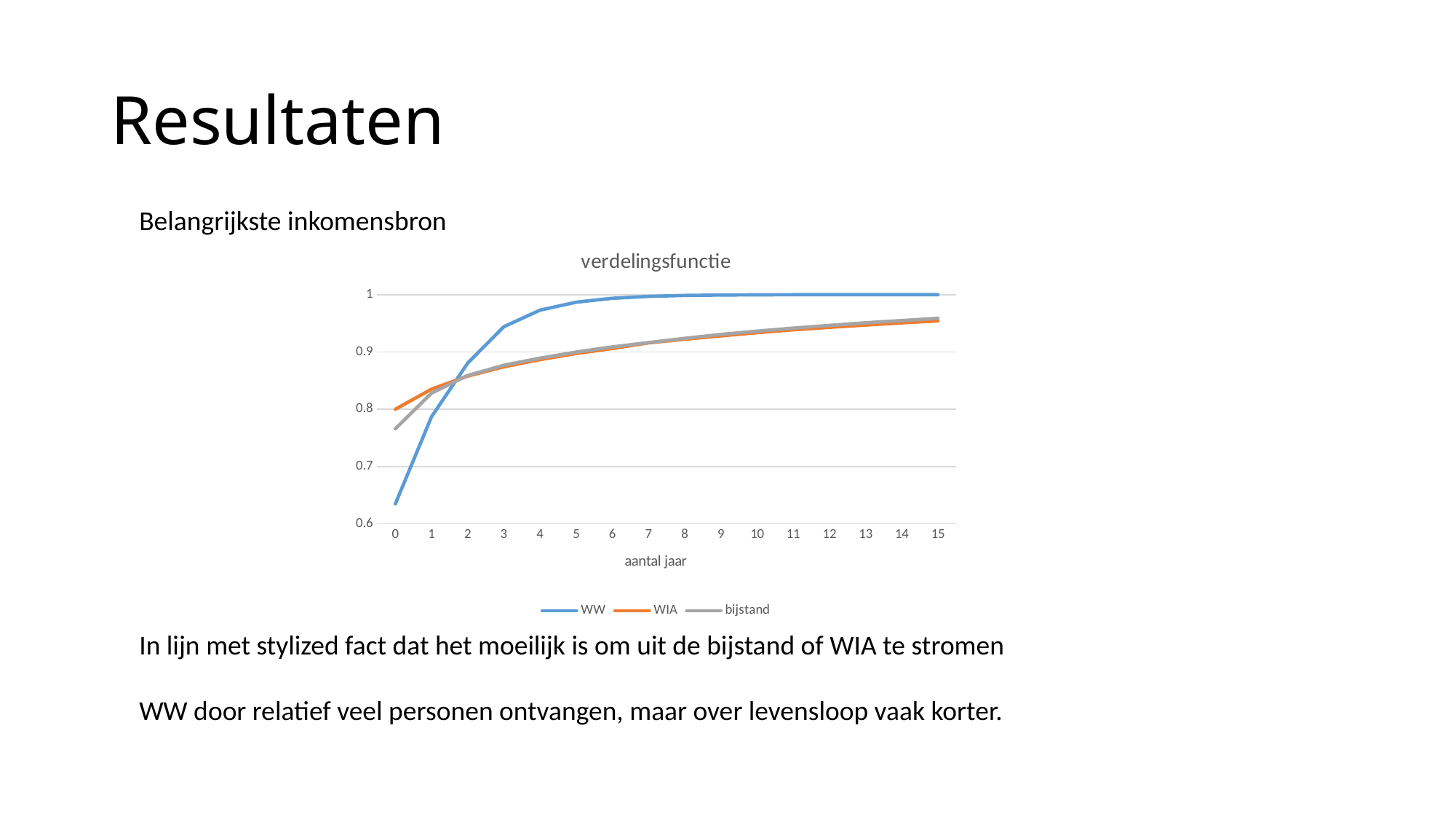
Is the value for WW at aantal jaar 0 greater or less than 0.7? less What is the title of the chart? verdelingsfunctie What kind of chart is shown on the slide? line chart Does the WW line rise or fall as aantal jaar increases from 0 to 15? rise How many series does the legend of the chart list? 3 Which series has the highest value at aantal jaar 15? WW What is the label of the x axis of the chart? aantal jaar At aantal jaar 5, which is larger: the value for WW or the value for WIA? WW Is the value for bijstand at aantal jaar 0 greater or less than 0.8? less Which series has the lowest value at aantal jaar 0? WW How many points along the x axis (aantal jaar) does each line cover? 16 Is the value for WIA at aantal jaar 15 greater or less than 0.9? greater